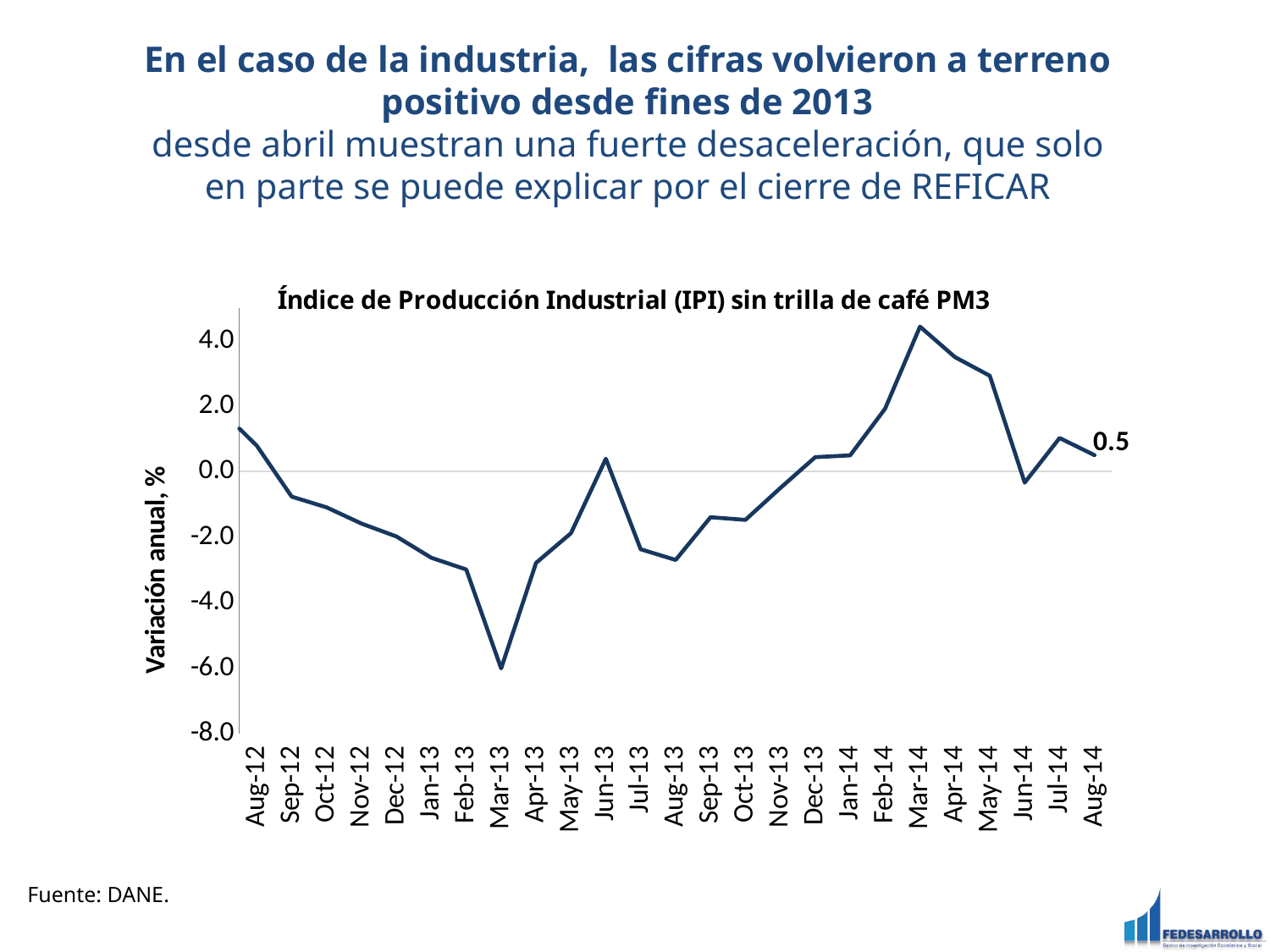
How many monthly data points are plotted on the x axis, from Aug-12 to Aug-14? 25 Do the values rise or fall between Mar-13 and Jun-13? rise Is the value for Mar-14 greater or less than 2.0? greater Is the value for Mar-13 greater or less than -4.0? less Do the values rise or fall between Mar-14 and Jun-14? fall Is the value for Feb-13 greater or less than -2.0? less Which month has the lowest value in the chart? Mar-13 Which is larger, the value for Mar-14 or the value for Mar-13? Mar-14 Which month has the highest value in the chart? Mar-14 What is the value shown for Aug-14 in the chart? 0.5 What kind of chart is shown on the slide? line chart What is the label of the vertical axis of the chart? Variación anual, %